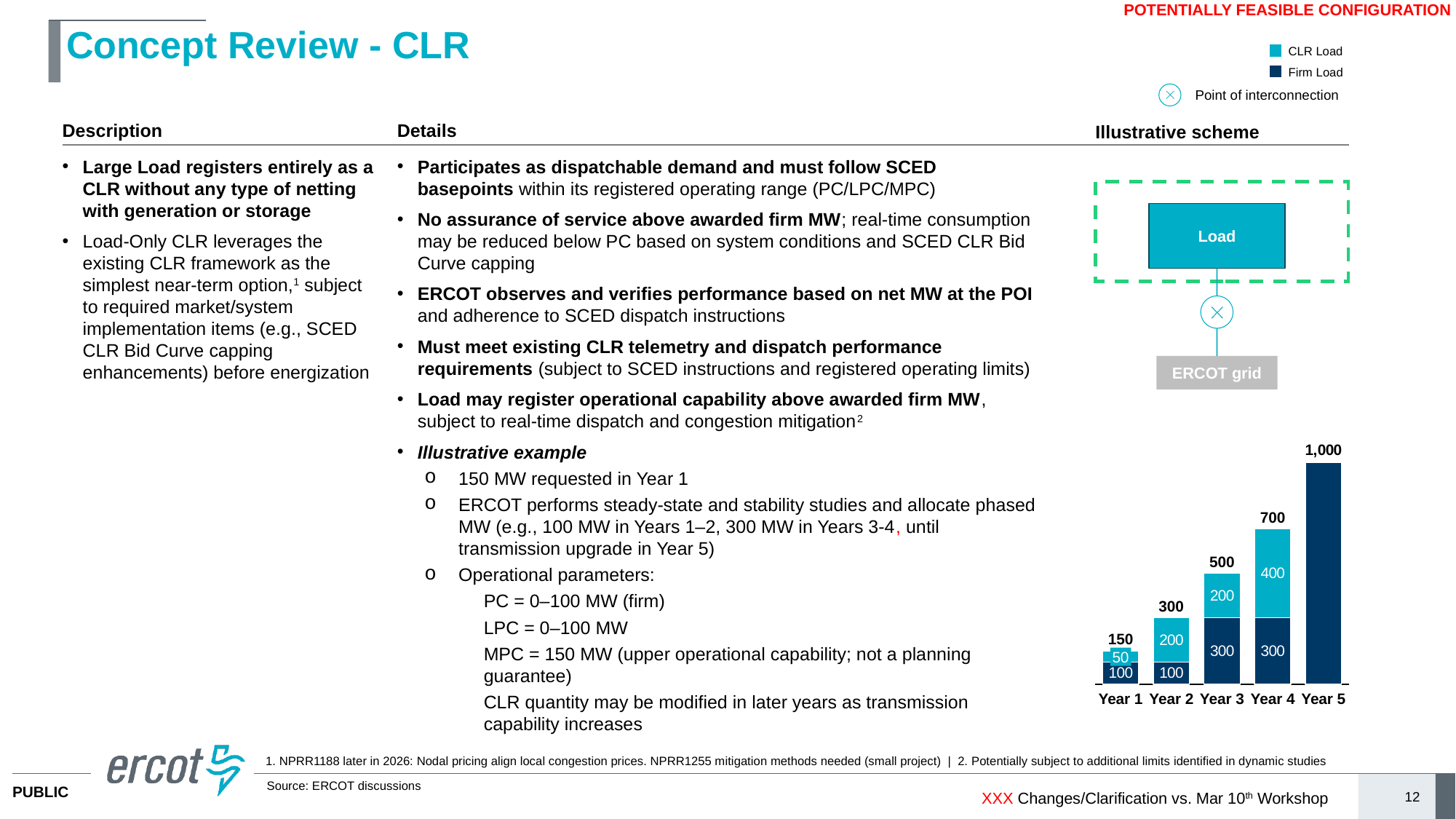
What is the total value shown above the bar for Year 3? 500 What is the CLR Load value in Year 2? 200 How many load series does the legend list for the bar chart? 2 What is the Firm Load value in Year 4? 300 Which year has the lowest total bar? Year 1 What is the difference between the total for Year 4 and the total for Year 3? 200 Do the total bar values rise or fall from Year 1 to Year 5? Rise Which year has the highest total bar? Year 5 Is the CLR Load in Year 4 larger or smaller than the CLR Load in Year 3? Larger What is the CLR Load value in Year 1? 50 What type of chart is shown under the Illustrative scheme? Stacked bar chart How many years are shown on the x axis of the bar chart? 5